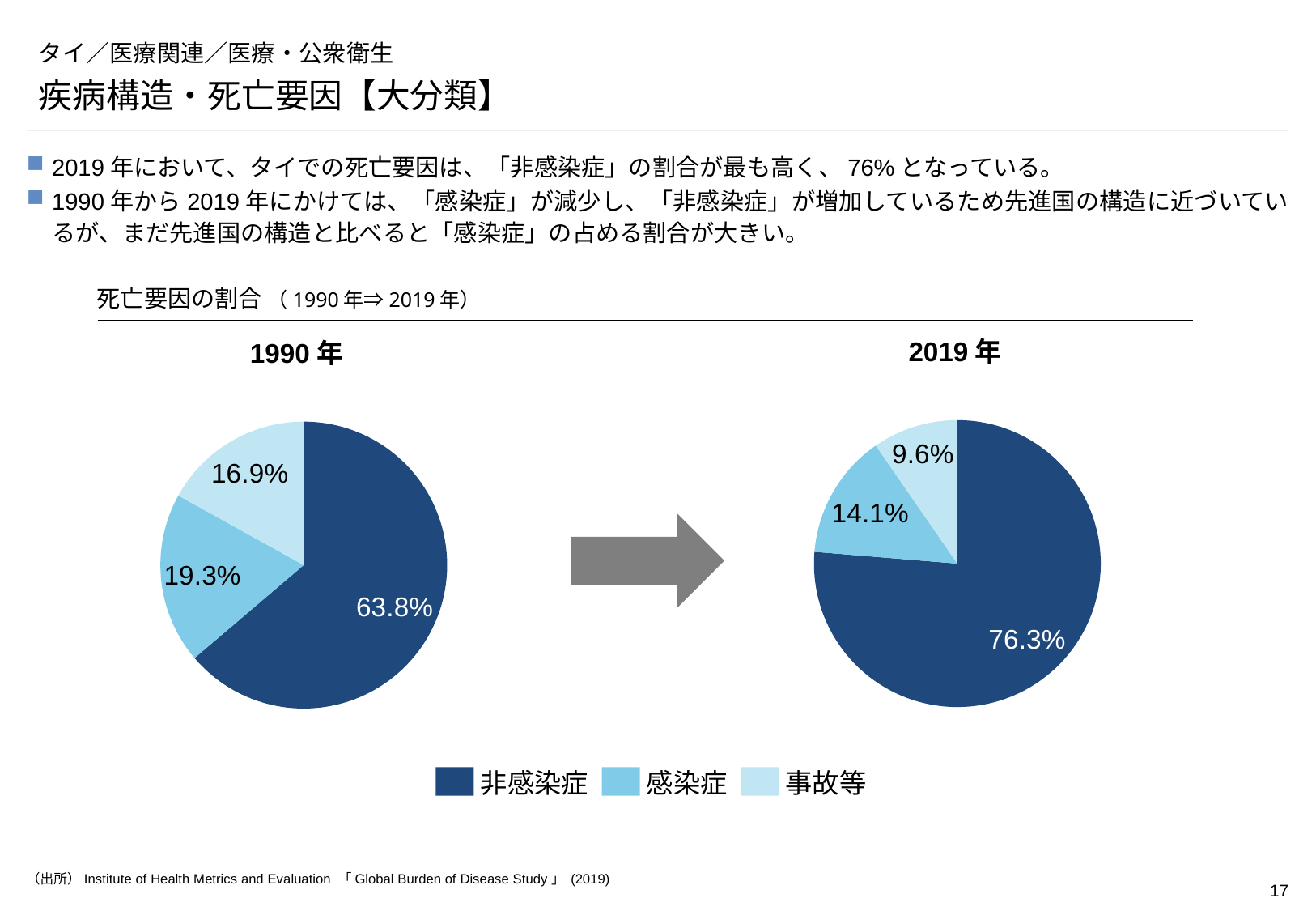
2019年の円グラフで、「事故等」の割合はいくらですか？ 9.6% 「非感染症」の割合は、1990年から2019年にかけて何ポイント増加しましたか？ 12.5ポイント 1990年の円グラフで、「非感染症」の割合はいくらですか？ 63.8% このスライドのグラフはどの種類のグラフですか？ 円グラフ 凡例には何種類の項目が示されていますか？ 3 2019年の円グラフで、「感染症」の割合はいくらですか？ 14.1% 「感染症」の割合は、1990年と2019年のどちらが大きいですか？ 1990年 1990年の円グラフで、最も割合が小さい項目はどれですか？ 事故等 2019年の円グラフで、最も割合が大きい項目はどれですか？ 非感染症 1990年の円グラフで、「事故等」の割合はいくらですか？ 16.9% 1990年の円グラフで、「感染症」と「事故等」の割合の差はいくらですか？ 2.4ポイント 2019年の円グラフで、最も割合が小さい項目はどれですか？ 事故等